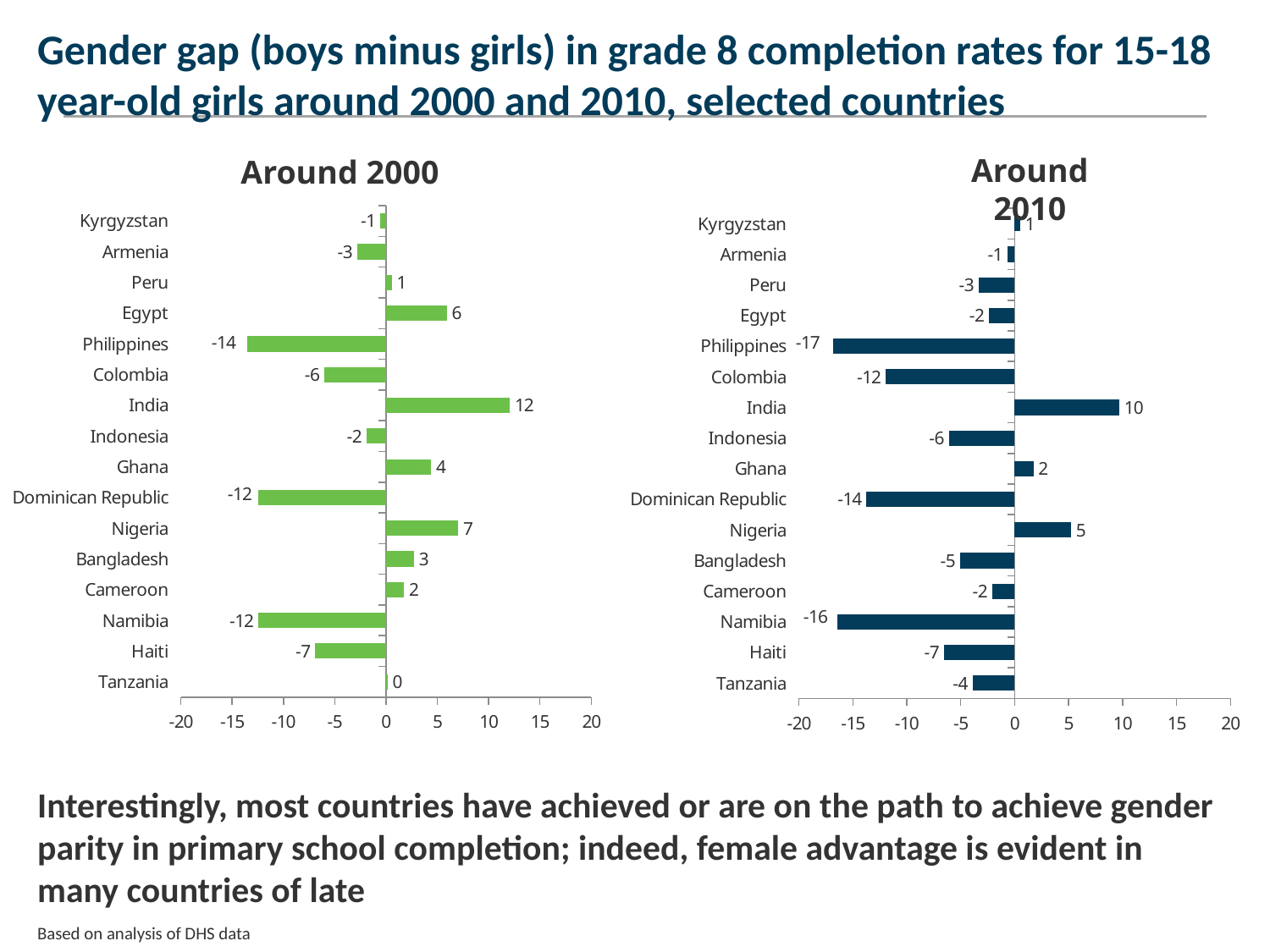
In the 'Around 2000' chart, which is larger, the value for Egypt or the value for Nigeria? Nigeria What type of chart is the 'Around 2000' chart? Bar chart In the 'Around 2010' chart, what is the difference between the values for India and Nigeria? 5 In the 'Around 2000' chart, which country has the highest value? India How many countries are shown in the 'Around 2010' chart? 16 In the 'Around 2010' chart, what is the value for the Philippines? -17 In the 'Around 2000' chart, which country has the lowest value? Philippines In the 'Around 2000' chart, what is the value for Tanzania? 0 In the 'Around 2010' chart, what is the value for Nigeria? 5 What colour are the bars in the 'Around 2010' chart? Dark blue In the 'Around 2000' chart, what is the value for India? 12 In the 'Around 2010' chart, which country has the lowest value? Philippines